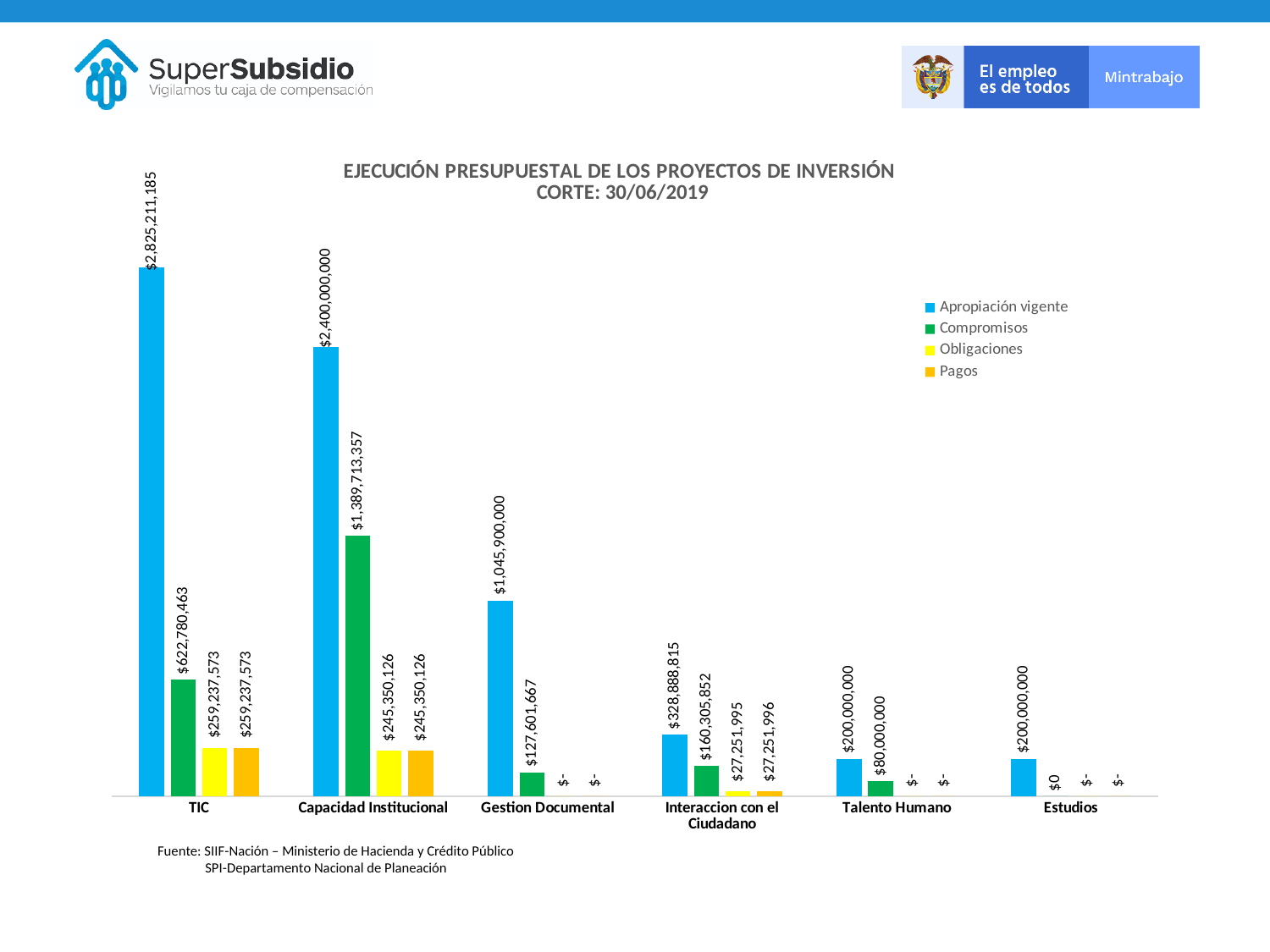
What is the Pagos value for Interaccion con el Ciudadano? $27,251,996 How many categories are shown on the x axis? 6 What kind of chart is shown on the slide? Bar chart What is the Compromisos value for Capacidad Institucional? $1,389,713,357 What is the Compromisos value for Talento Humano? $80,000,000 Which category has the lowest Compromisos value? Estudios What is the cut-off date shown in the chart title? 30/06/2019 Which category has the highest Apropiación vigente? TIC How many series does the legend list? 4 What is the Apropiación vigente value for TIC? $2,825,211,185 What is the difference between the Apropiación vigente and Compromisos values for Gestion Documental? $918,298,333 Which is larger: the Compromisos value for TIC or the Compromisos value for Capacidad Institucional? Capacidad Institucional